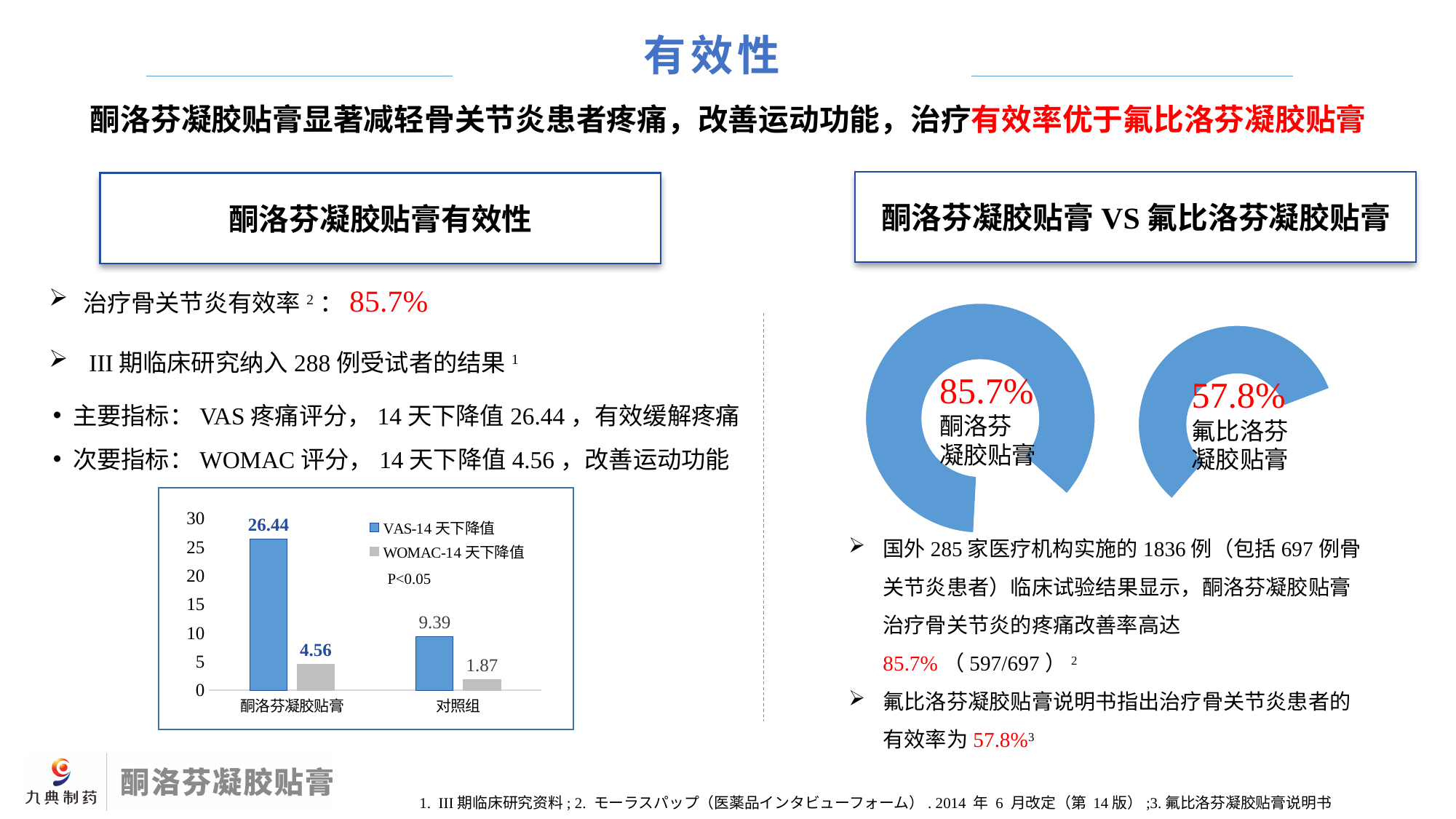
In the donut charts on the right, which product has the higher percentage, 酮洛芬凝胶贴膏 or 氟比洛芬凝胶贴膏? 酮洛芬凝胶贴膏 In the bar chart on the left, what is the difference between the VAS-14天下降值 of 酮洛芬凝胶贴膏 and 对照组? 17.05 In the bar chart on the left, which category has the highest VAS-14天下降值? 酮洛芬凝胶贴膏 In the donut charts on the right, what percentage is shown for 氟比洛芬凝胶贴膏? 57.8% What kind of chart is shown at the bottom left of the slide? Bar chart In the bar chart on the left, which is larger: the WOMAC-14天下降值 for 酮洛芬凝胶贴膏 or for 对照组? 酮洛芬凝胶贴膏 In the bar chart on the left, what is the VAS-14天下降值 for 酮洛芬凝胶贴膏? 26.44 In the bar chart on the left, what is the WOMAC-14天下降值 for 对照组? 1.87 In the bar chart on the left, what is the WOMAC-14天下降值 for 酮洛芬凝胶贴膏? 4.56 In the bar chart on the left, how many categories are shown on the x axis? 2 In the bar chart on the left, what is the VAS-14天下降值 for 对照组? 9.39 In the bar chart on the left, how many series does the legend list? 2